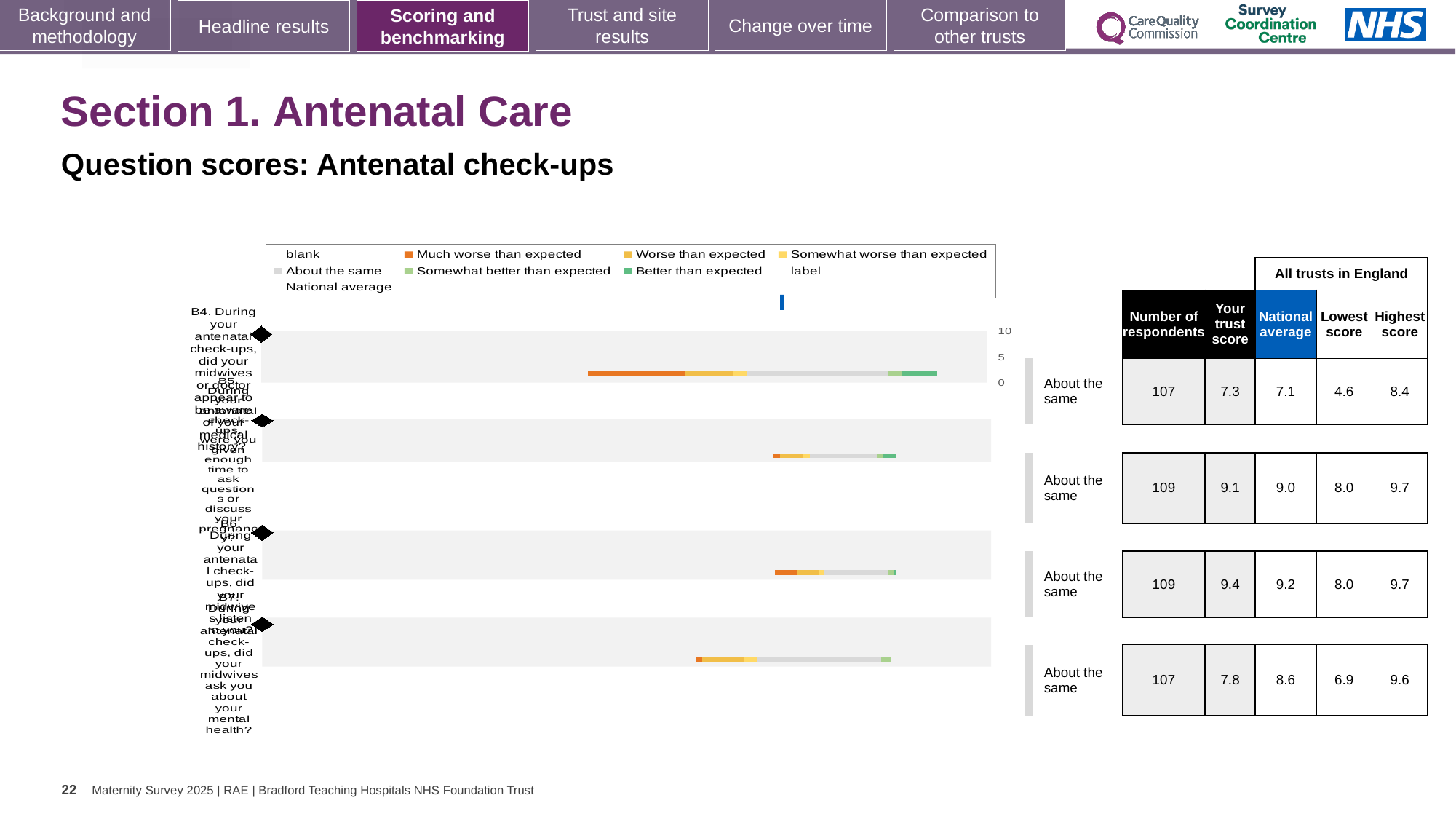
In the table beside the chart, what is the National average for the first row (B4)? 7.1 Which row has the lowest 'Your trust score' in the table beside the chart? B4 (first row), 7.3 Which row has the highest 'Your trust score' in the table beside the chart? B6 (third row), 9.4 In the table beside the chart, what is the Highest score for the last row (B7, mental health)? 9.6 What benchmark category is shown next to each of the four bars? About the same For the third row (B6), which is larger: Your trust score or the National average? Your trust score (9.4) How many entries does the chart legend list? 9 For the last row (B7), what is the difference between the National average (8.6) and Your trust score (7.8)? 0.8 How many question rows (bars) does the chart show? 4 In the table beside the chart, what is the 'Your trust score' for the first row (B4, awareness of medical history)? 7.3 In the table beside the chart, what is the Number of respondents for the second row (B5)? 109 What kind of chart is shown on the slide? bar chart